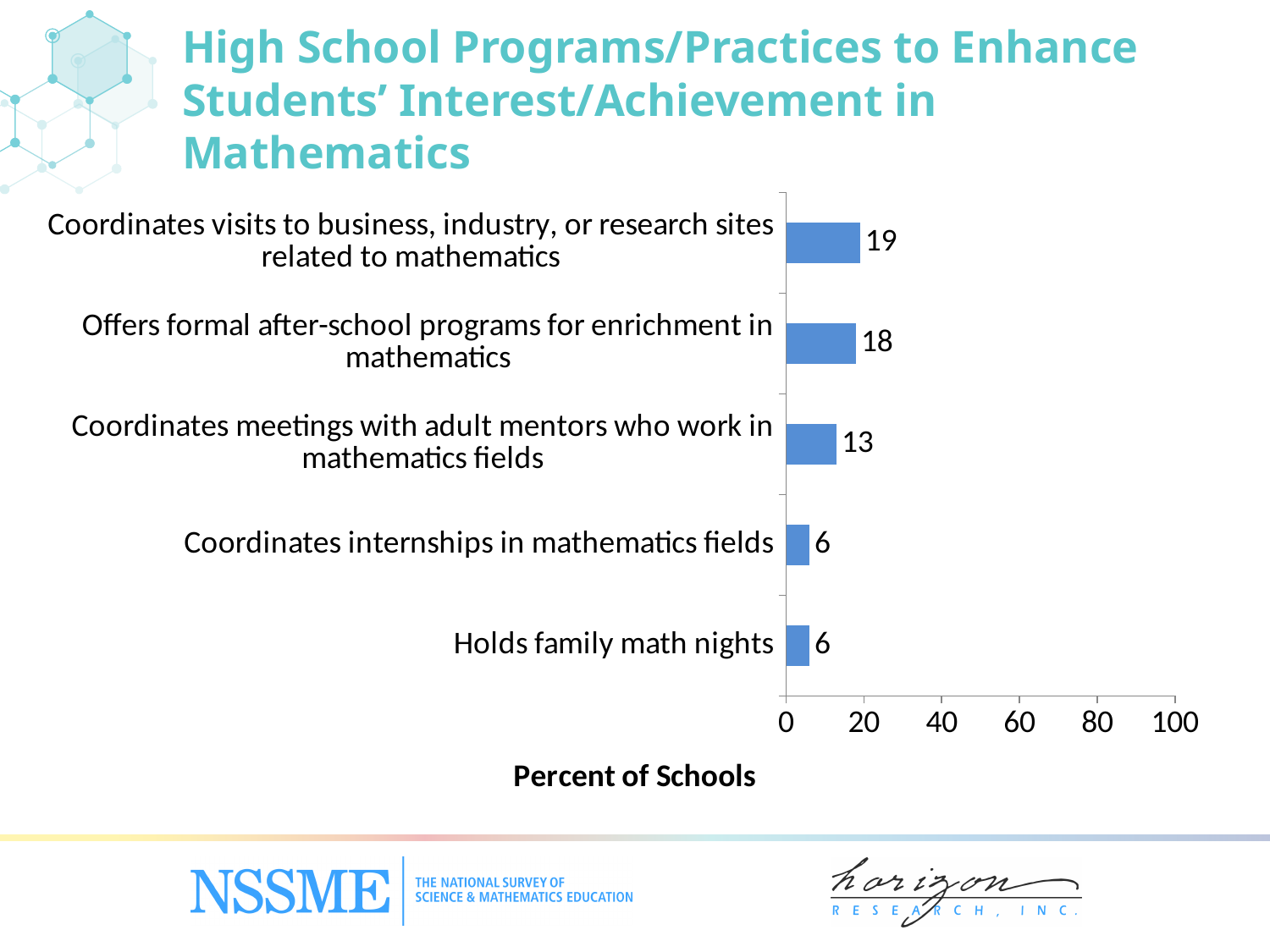
Is the value for coordinating visits to business, industry, or research sites greater or less than 20? less Which program/practice has the highest percent of schools? Coordinates visits to business, industry, or research sites related to mathematics Which is larger: the percent of schools offering formal after-school programs for enrichment in mathematics or the percent coordinating internships in mathematics fields? Offers formal after-school programs for enrichment in mathematics What percent of schools coordinate visits to business, industry, or research sites related to mathematics? 19 How many programs/practices are shown in the chart? 5 What is the difference in percent of schools between coordinating visits to business, industry, or research sites and coordinating meetings with adult mentors? 6 What kind of chart is shown on the slide? Bar chart What is the difference in percent of schools between offering formal after-school programs and holding family math nights? 12 What percent of schools hold family math nights? 6 What is the label of the horizontal axis? Percent of Schools What percent of schools offer formal after-school programs for enrichment in mathematics? 18 What percent of schools coordinate meetings with adult mentors who work in mathematics fields? 13